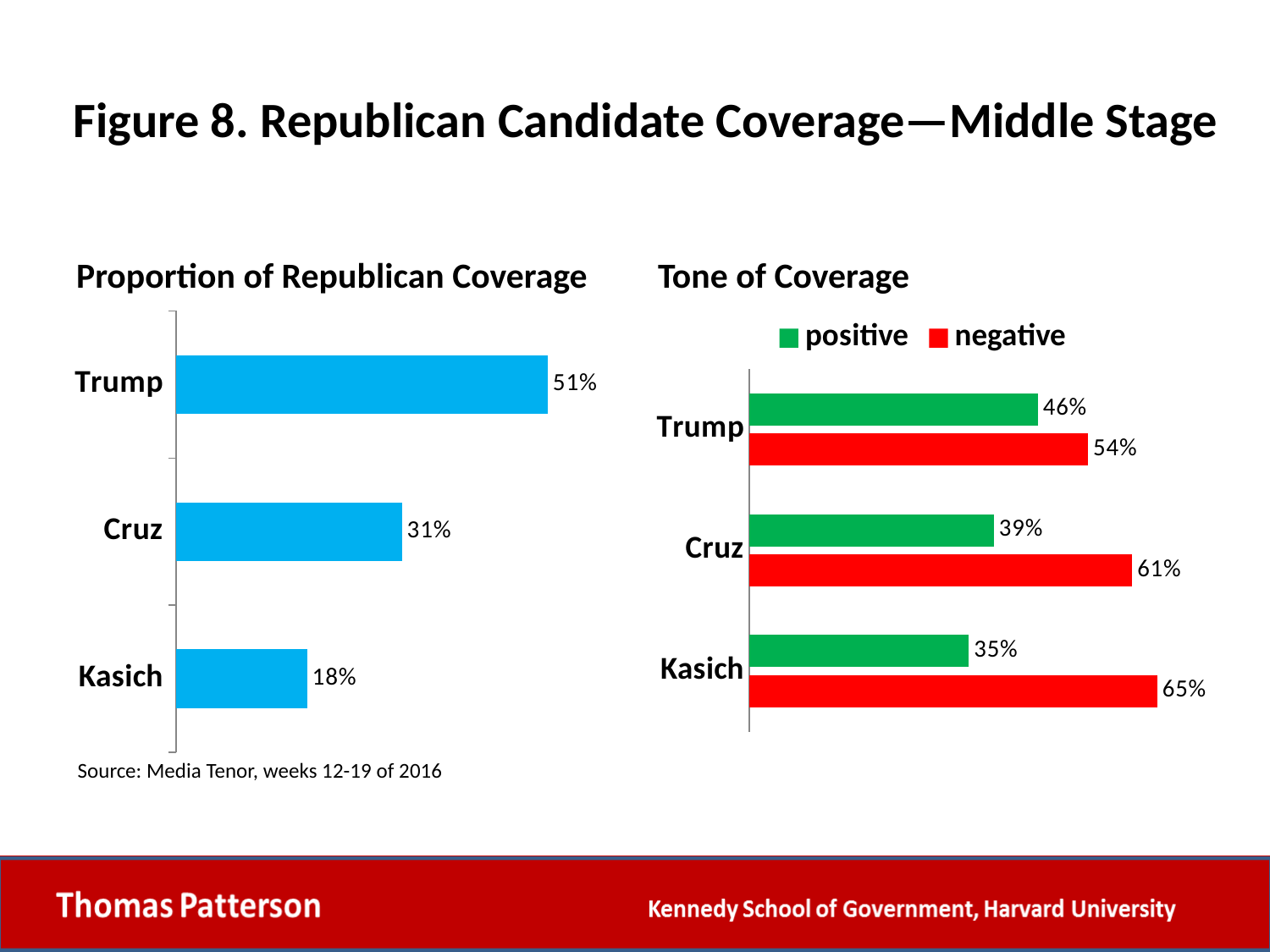
In the 'Proportion of Republican Coverage' chart, what is the difference between Trump's and Cruz's values? 20% In the 'Tone of Coverage' chart, is Cruz's positive value or Kasich's positive value larger? Cruz's positive value What kind of chart is the 'Proportion of Republican Coverage' chart? Bar chart In the 'Tone of Coverage' chart, what is the positive value for Kasich? 35% In the 'Proportion of Republican Coverage' chart, how many candidates are shown? 3 In the 'Proportion of Republican Coverage' chart, what is the value for Trump? 51% In the 'Tone of Coverage' chart, which candidate has the highest negative value? Kasich In the 'Proportion of Republican Coverage' chart, which candidate has the lowest proportion of coverage? Kasich In the 'Tone of Coverage' chart, which candidate has the highest positive value? Trump In the 'Tone of Coverage' chart, what is the negative value for Cruz? 61% In the 'Tone of Coverage' chart, what is the difference between Trump's negative and positive values? 8% How many series does the legend of the 'Tone of Coverage' chart list? 2